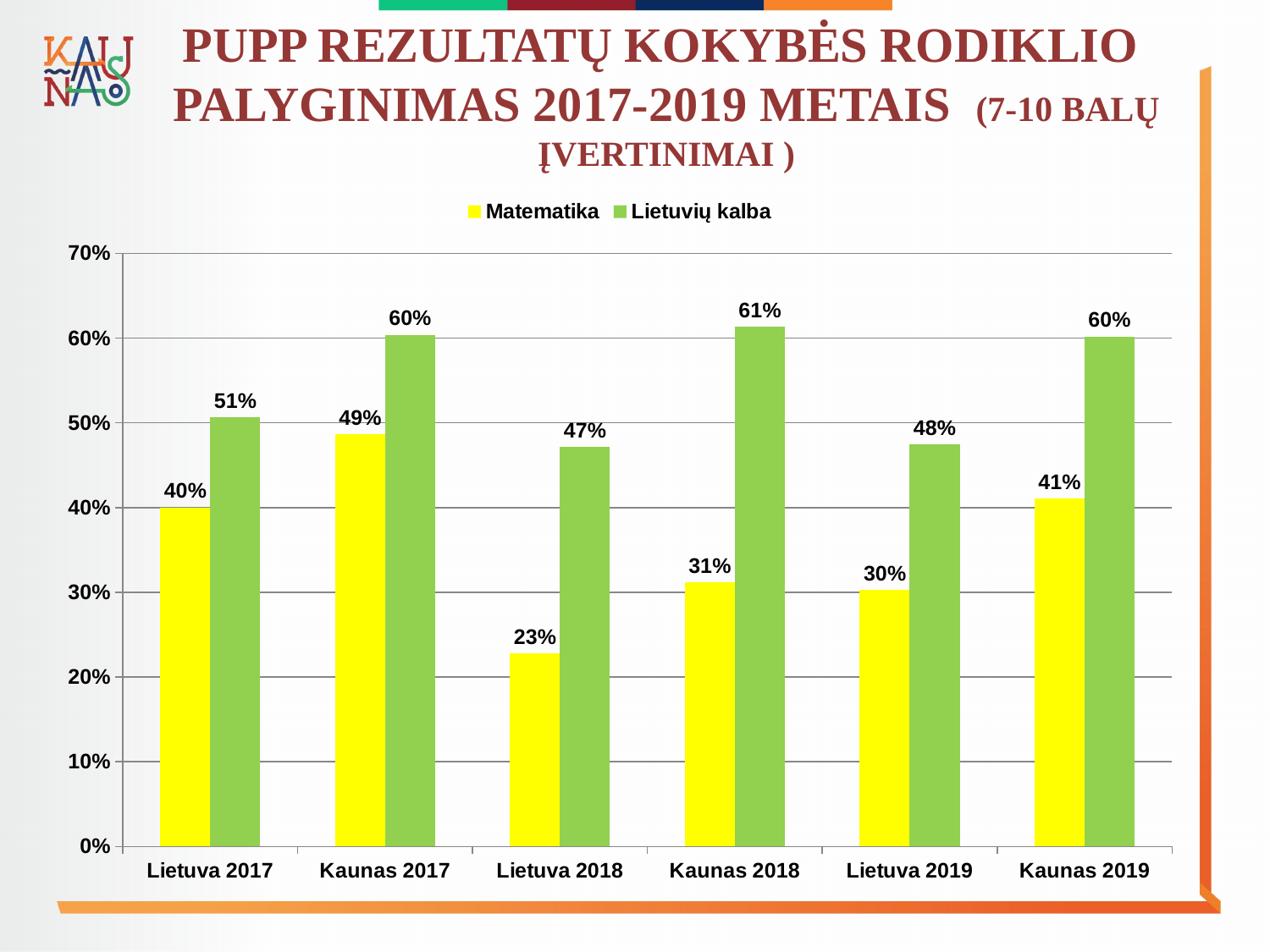
Which category has the lowest Matematika value? Lietuva 2018 What is the difference between the Lietuvių kalba and Matematika values for Lietuva 2018? 24% Which colour represents the Matematika series? yellow How many categories are shown on the x axis? 6 What is the Matematika value for Kaunas 2019? 41% How many series does the legend list? 2 What is the Matematika value for Lietuva 2018? 23% Which is larger: the Matematika value for Kaunas 2017 or the Matematika value for Kaunas 2019? Kaunas 2017 What kind of chart is shown on the slide? bar chart Which category has the highest Lietuvių kalba value? Kaunas 2018 Is the Lietuvių kalba value for Lietuva 2017 greater or less than 60%? less What is the Lietuvių kalba value for Kaunas 2018? 61%